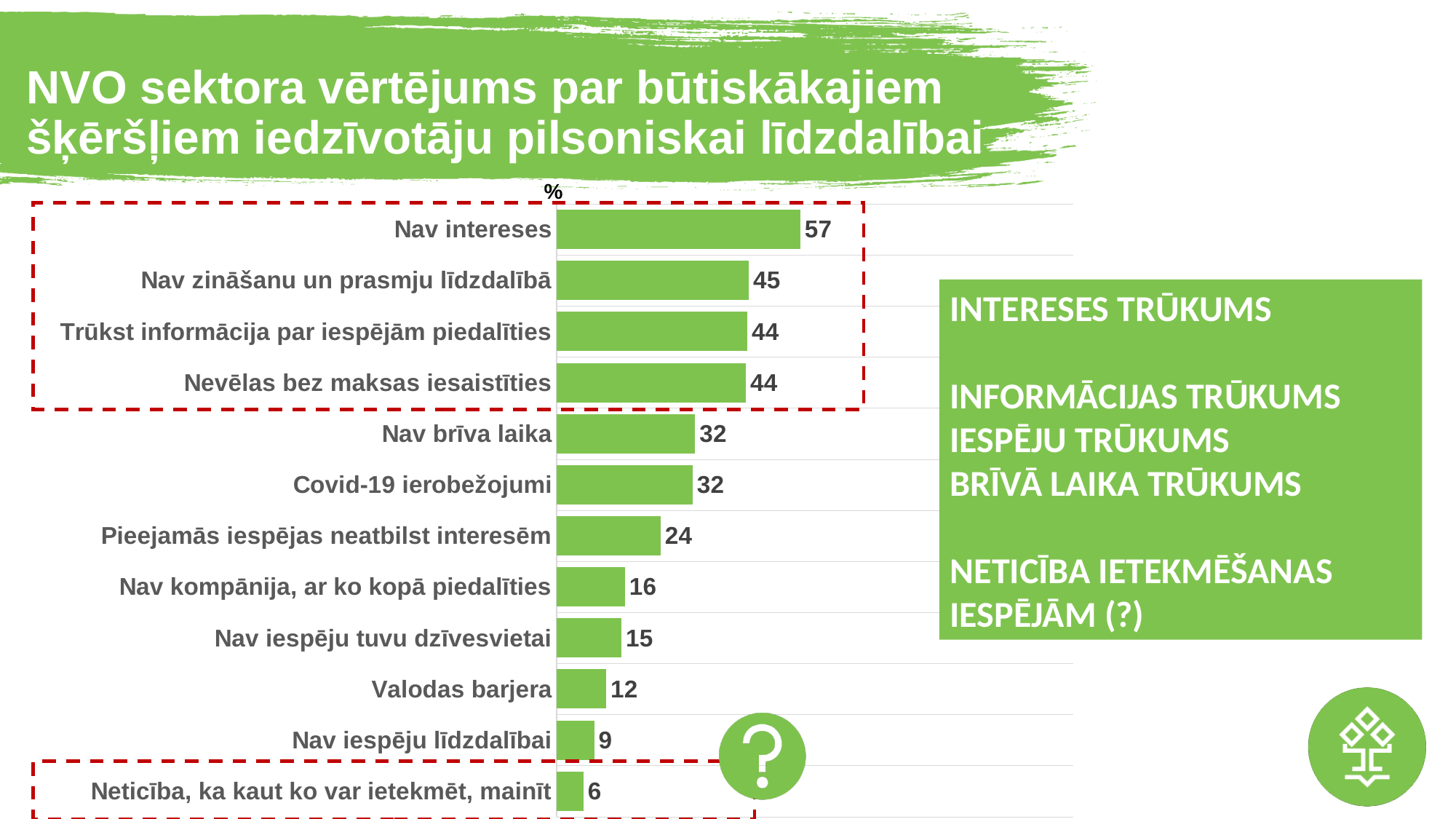
Which is larger: the value for "Pieejamās iespējas neatbilst interesēm" or the value for "Nav kompānija, ar ko kopā piedalīties"? Pieejamās iespējas neatbilst interesēm What is the value for "Valodas barjera"? 12 What is the value for "Covid-19 ierobežojumi"? 32 What unit is indicated at the top of the chart's value axis? % What kind of chart is shown on the slide? Bar chart What is the value for "Nav intereses"? 57 How many categories are shown in the chart? 12 What is the difference between the values for "Nav intereses" and "Nav zināšanu un prasmju līdzdalībā"? 12 Which category has the lowest value? Neticība, ka kaut ko var ietekmēt, mainīt What is the difference between the values for "Nav iespēju tuvu dzīvesvietai" and "Nav iespēju līdzdalībai"? 6 Which category has the highest value? Nav intereses What colour are the bars in the chart? Green